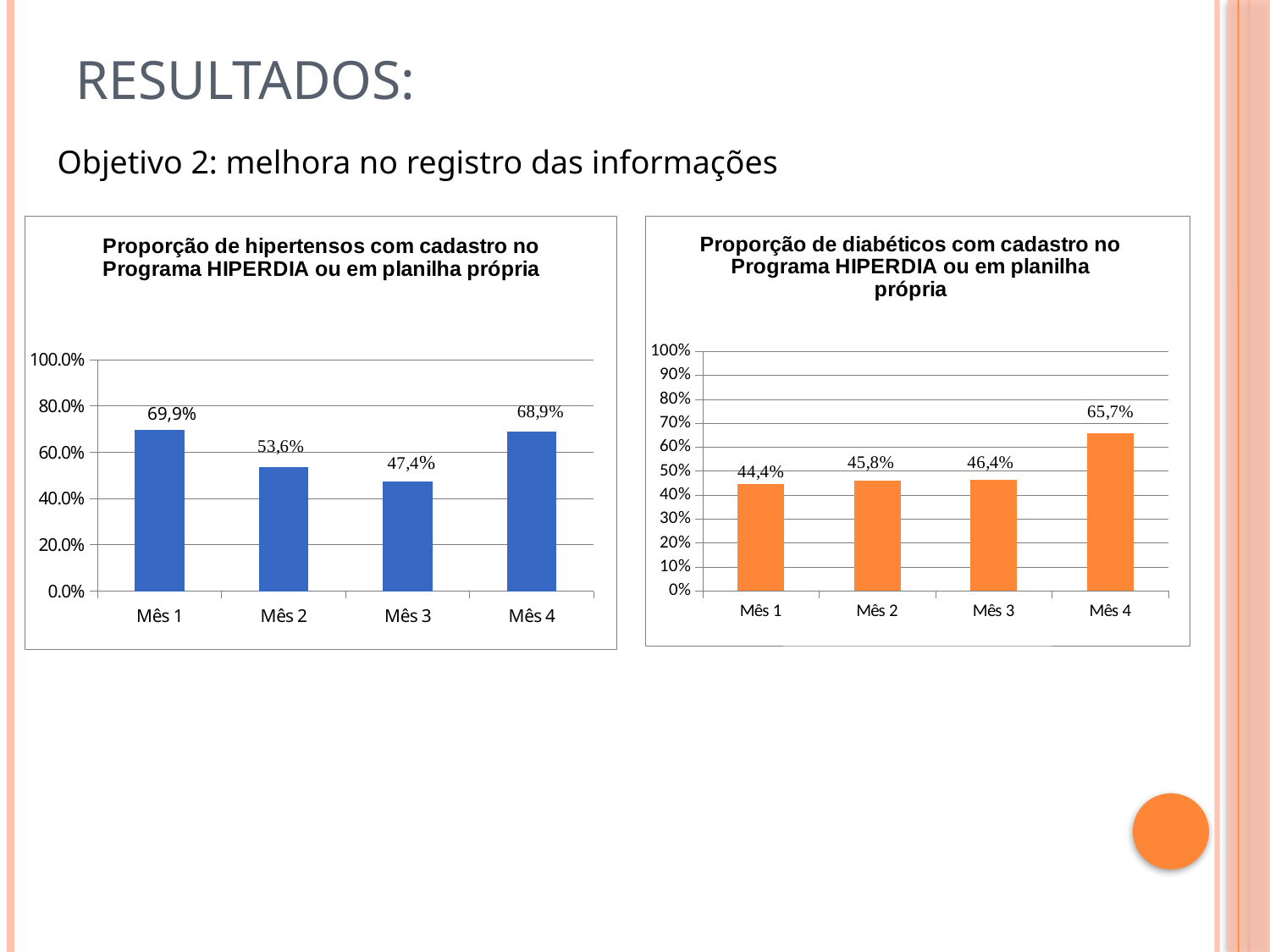
In the chart 'Proporção de diabéticos com cadastro no Programa HIPERDIA ou em planilha própria', do the values rise or fall from Mês 1 to Mês 4? rise Which is larger: the Mês 3 value in the hipertensos chart or the Mês 3 value in the diabéticos chart? hipertensos chart (47,4%) In the chart 'Proporção de hipertensos com cadastro no Programa HIPERDIA ou em planilha própria', how many months are shown on the x axis? 4 In the chart 'Proporção de hipertensos com cadastro no Programa HIPERDIA ou em planilha própria', what is the value for Mês 1? 69,9% In the chart 'Proporção de hipertensos com cadastro no Programa HIPERDIA ou em planilha própria', what is the difference between Mês 1 and Mês 2? 16,3% In the chart 'Proporção de hipertensos com cadastro no Programa HIPERDIA ou em planilha própria', what is the value for Mês 3? 47,4% In the chart 'Proporção de diabéticos com cadastro no Programa HIPERDIA ou em planilha própria', what is the value for Mês 4? 65,7% In the chart 'Proporção de hipertensos com cadastro no Programa HIPERDIA ou em planilha própria', which month has the lowest value? Mês 3 In the chart 'Proporção de diabéticos com cadastro no Programa HIPERDIA ou em planilha própria', what is the difference between Mês 4 and Mês 1? 21,3% In the chart 'Proporção de diabéticos com cadastro no Programa HIPERDIA ou em planilha própria', which month has the highest value? Mês 4 In the chart 'Proporção de diabéticos com cadastro no Programa HIPERDIA ou em planilha própria', what is the value for Mês 2? 45,8% What type of chart is the chart on the right of the slide? bar chart